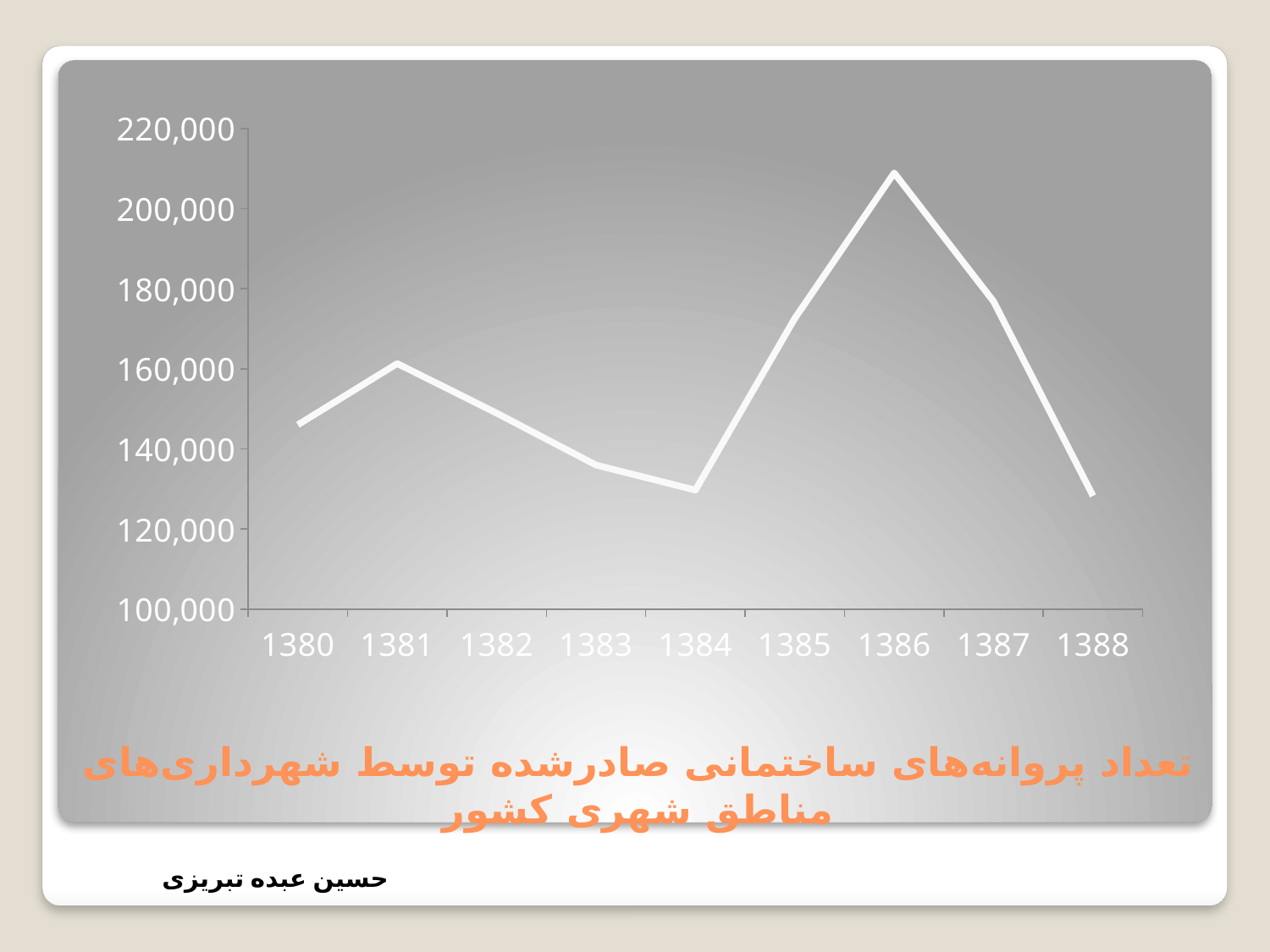
Is the value for 1386 greater or less than 200,000? greater Is the value for 1387 greater or less than 180,000? less Is the value for 1385 greater or less than 160,000? greater Which is larger, the value for 1380 or the value for 1384? 1380 Which is larger, the value for 1381 or the value for 1386? 1386 Do the values rise or fall from 1386 to 1388? fall What kind of chart is shown on the slide? line chart Do the values rise or fall from 1384 to 1386? rise How many years are plotted along the x axis? 9 Which year has the highest value on the chart? 1386